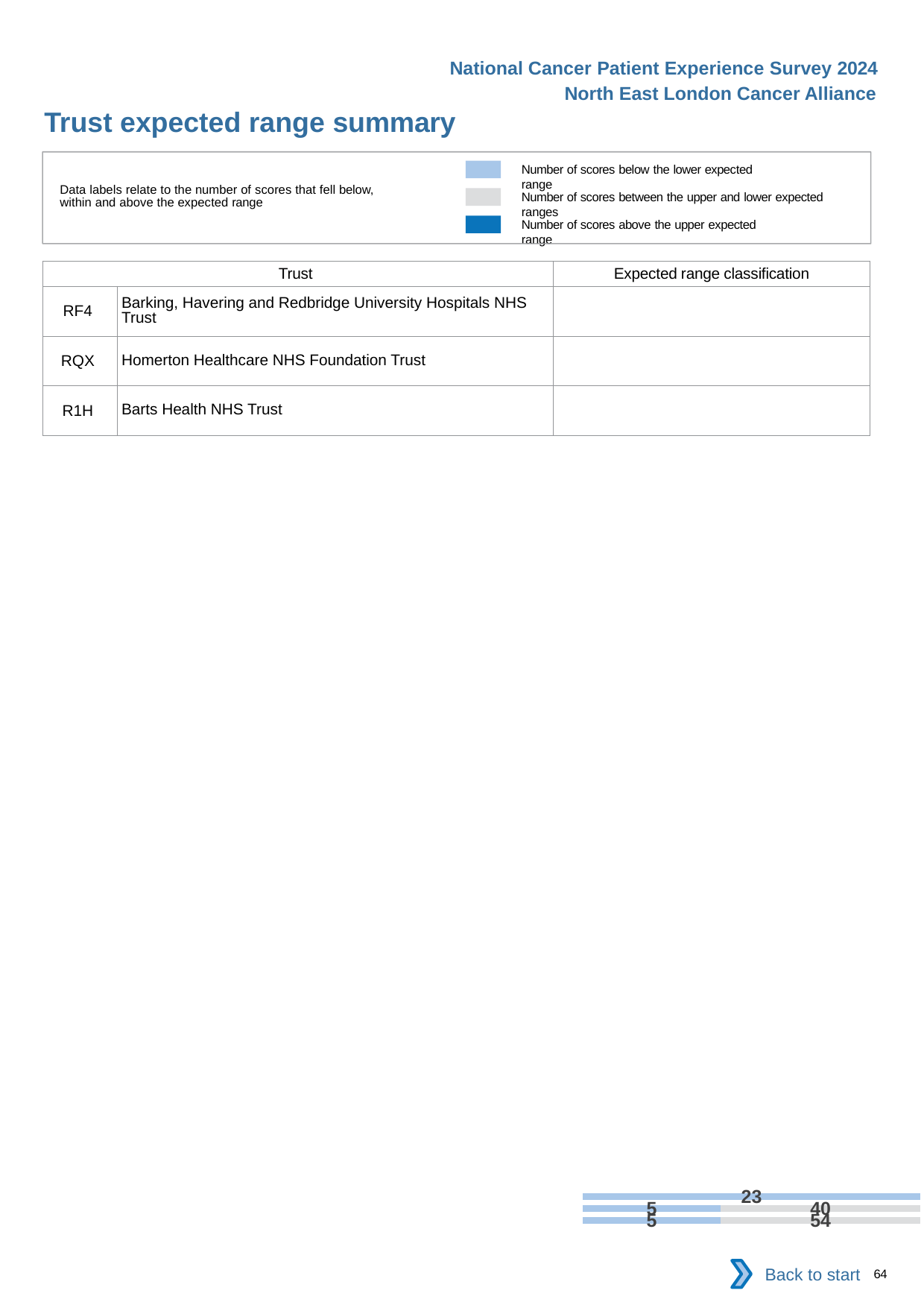
What is the largest data label printed on the chart bars? 54 How many trusts are listed as categories on the slide? 3 What kind of chart is shown on the slide? bar chart According to the legend, what does the light blue colour represent? Number of scores below the lower expected range What is the smallest data label printed on the chart bars? 5 According to the legend, what does the dark blue colour represent? Number of scores above the upper expected range How many categories does the legend list for the chart? 3